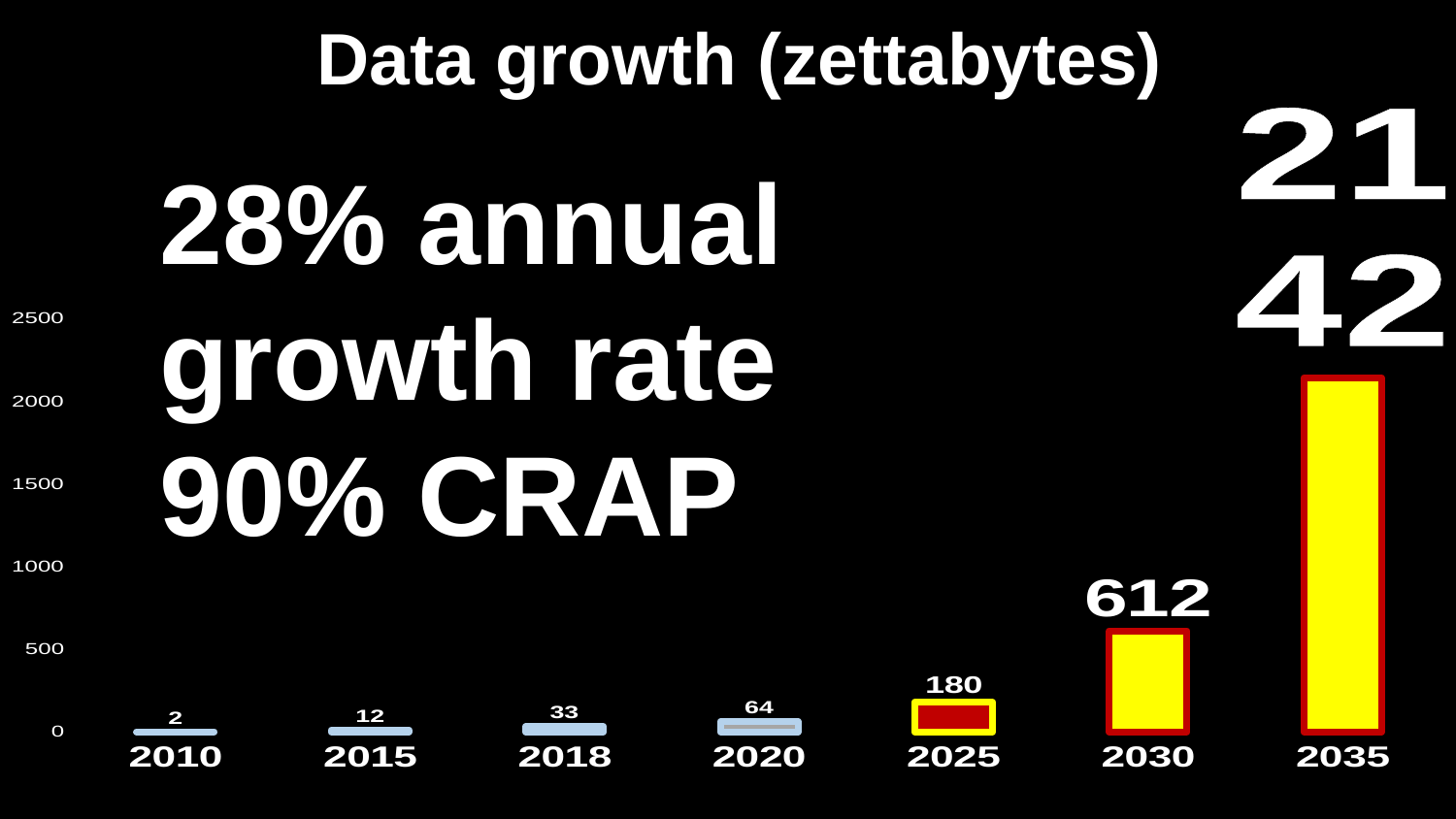
What is the value for 2030? 612 What kind of chart is this? bar chart Do the values rise or fall from 2010 to 2035? rise Which is larger, the value for 2018 or the value for 2015? 2018 What is the difference between the values for 2030 and 2025? 432 Which year has the highest value? 2035 Which year has the lowest value? 2010 What is the value for 2020? 64 Is the value for 2035 greater or less than 2000? greater How many years are shown on the x axis? 7 What is the value for 2025? 180 What is the value for 2010? 2